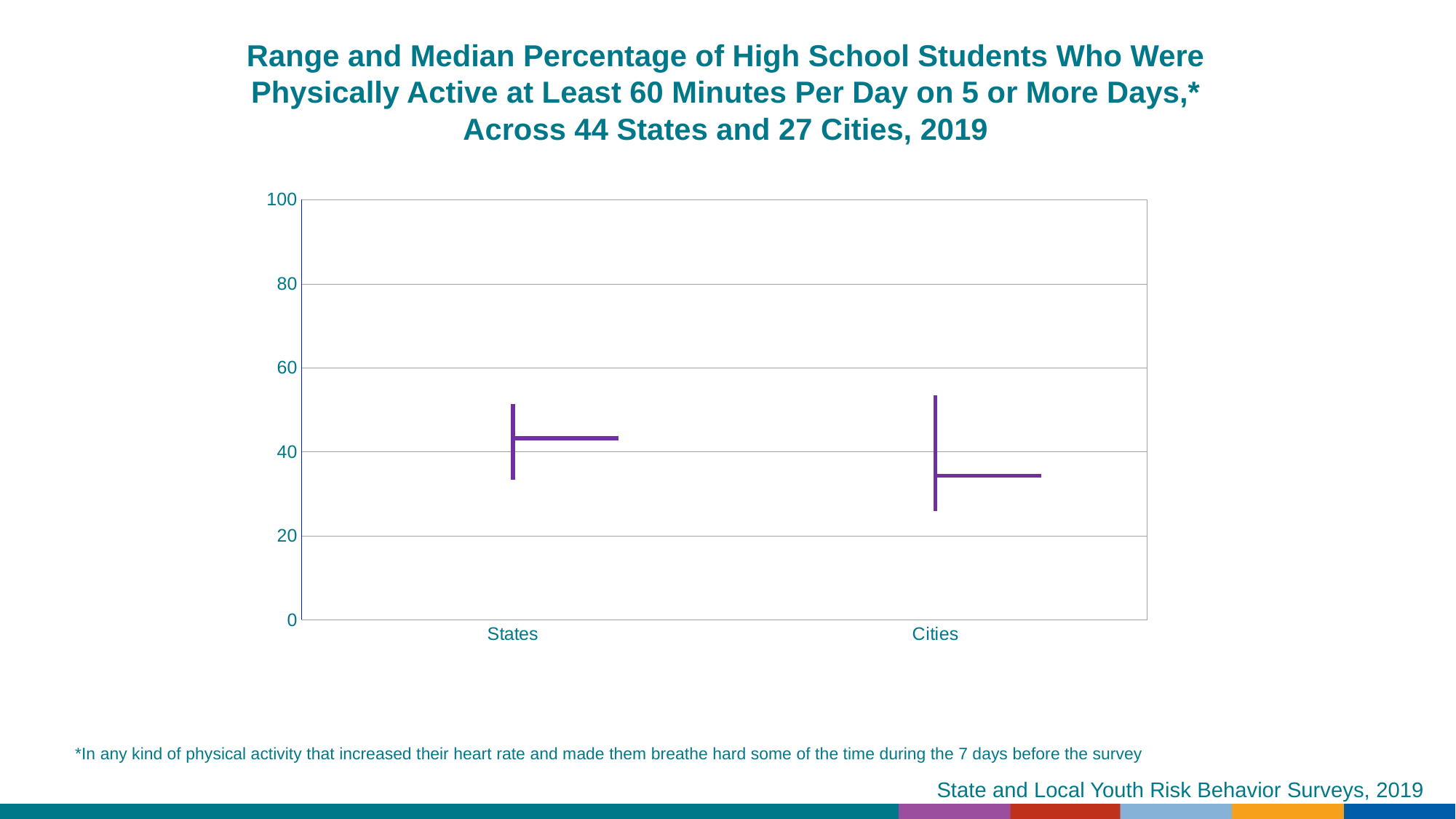
Is the median value for States greater or less than 40? greater Which category has the lower bottom of its range, States or Cities? Cities Is the median value for Cities greater or less than 20? greater Is the top of the range for Cities greater or less than 40? greater How many categories are shown on the x axis of the chart? 2 Which category has the higher median value, States or Cities? States Does the median value rise or fall from States to Cities along the x axis? fall What is the maximum value shown on the y axis? 100 What are the two categories shown on the x axis? States and Cities